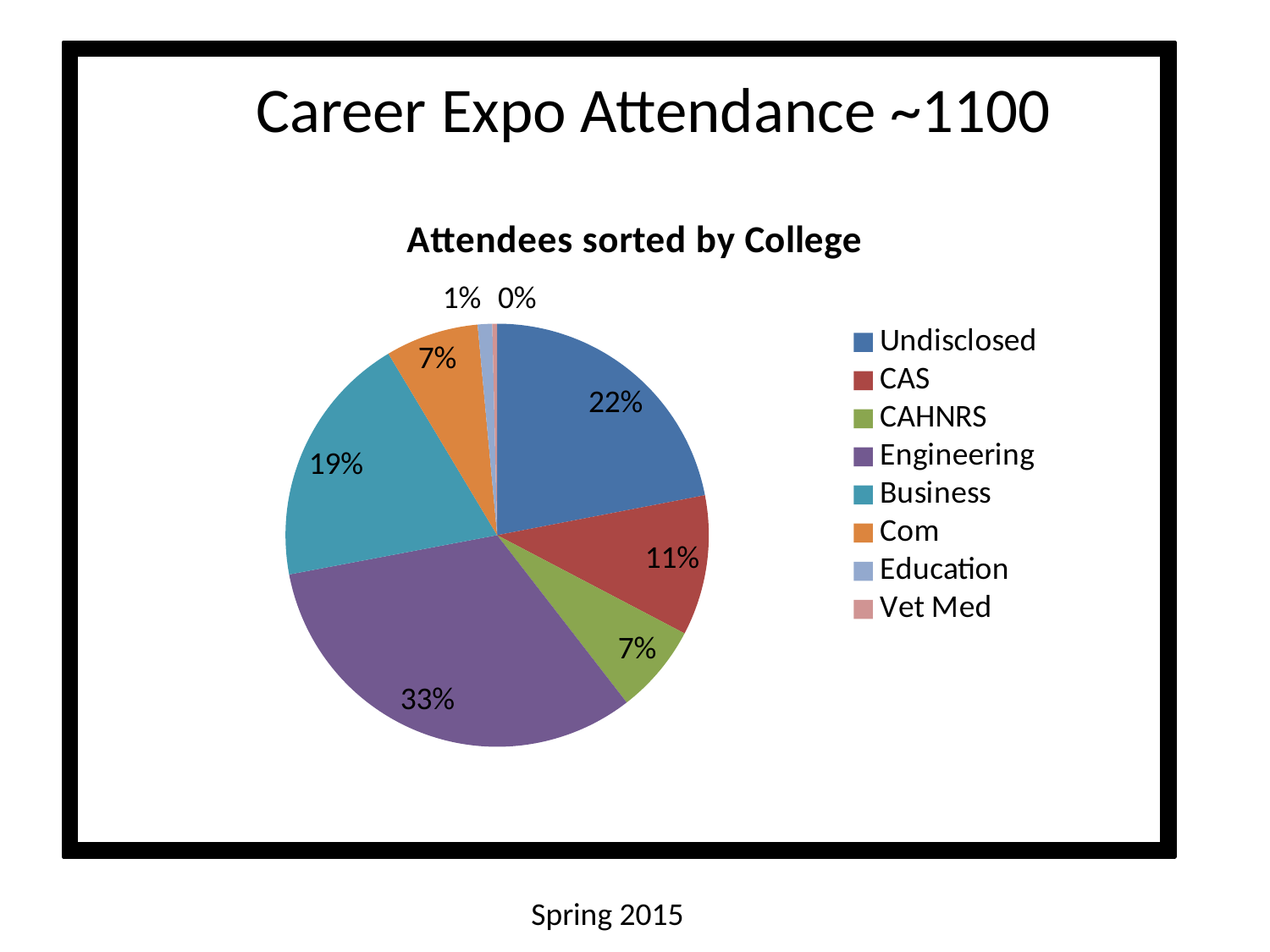
What share of attendees is Engineering? 33% What share of attendees is Education? 1% What is the title of the chart? Attendees sorted by College What kind of chart is shown on the slide? pie chart Which college has the largest share of attendees? Engineering How many categories does the legend list? 8 Which is larger, the Business share or the CAS share? Business What is the difference between the Engineering share and the Undisclosed share? 11% Which college has the smallest share of attendees? Vet Med What share of attendees is Undisclosed? 22%